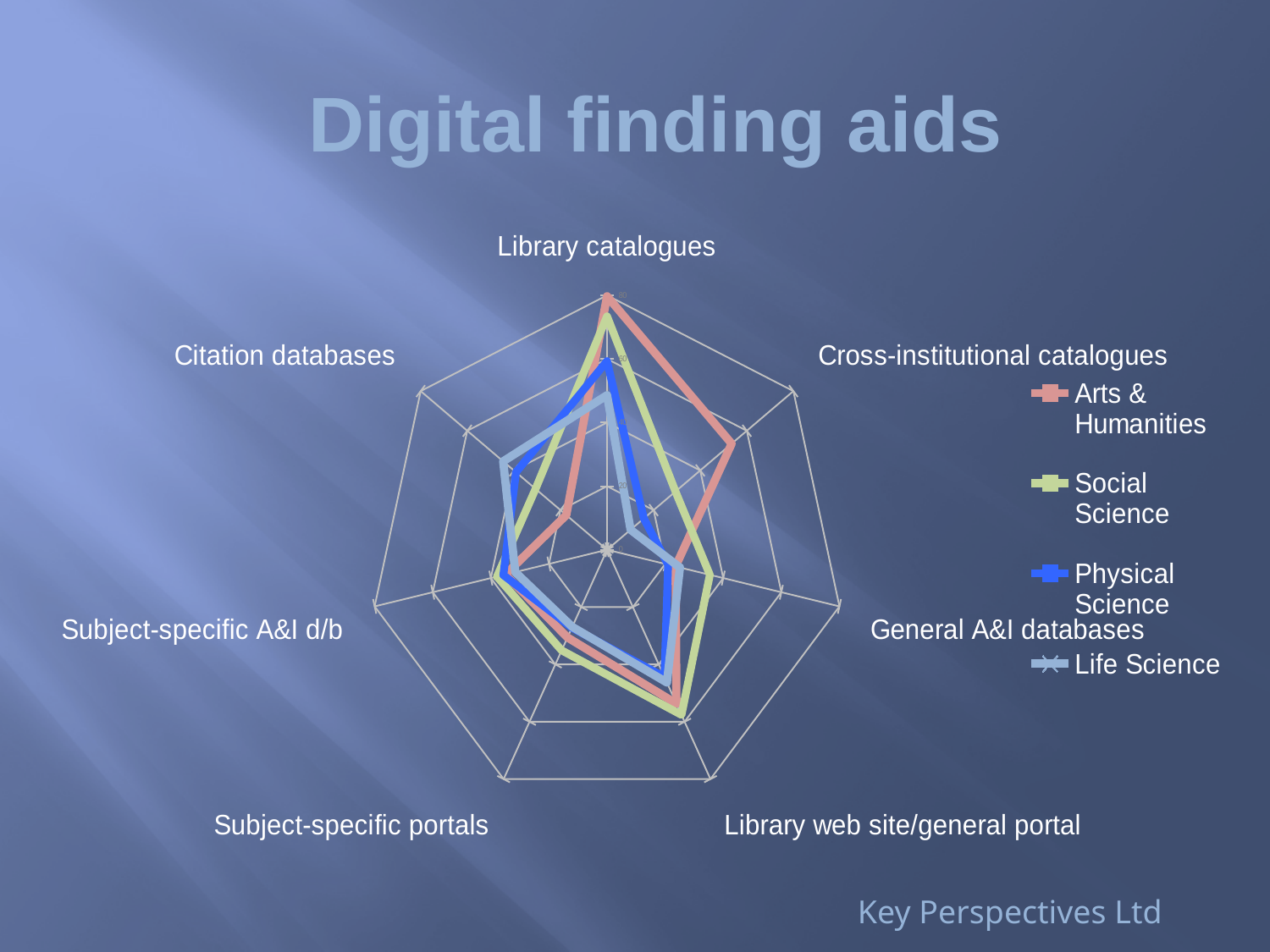
How many series does the legend list? 4 Which series is drawn in green in the chart? Social Science Which series has the highest value for Cross-institutional catalogues? Arts & Humanities How many categories (axes) does the radar chart have? 7 Which series has the highest value for Citation databases? Life Science Which series has the highest value for General A&I databases? Social Science For Citation databases, which is larger: Life Science or Arts & Humanities? Life Science For Library catalogues, which is larger: Arts & Humanities or Physical Science? Arts & Humanities What kind of chart is shown on the slide? Radar chart Which series has the lowest value for Citation databases? Arts & Humanities What is the title of the slide containing the chart? Digital finding aids